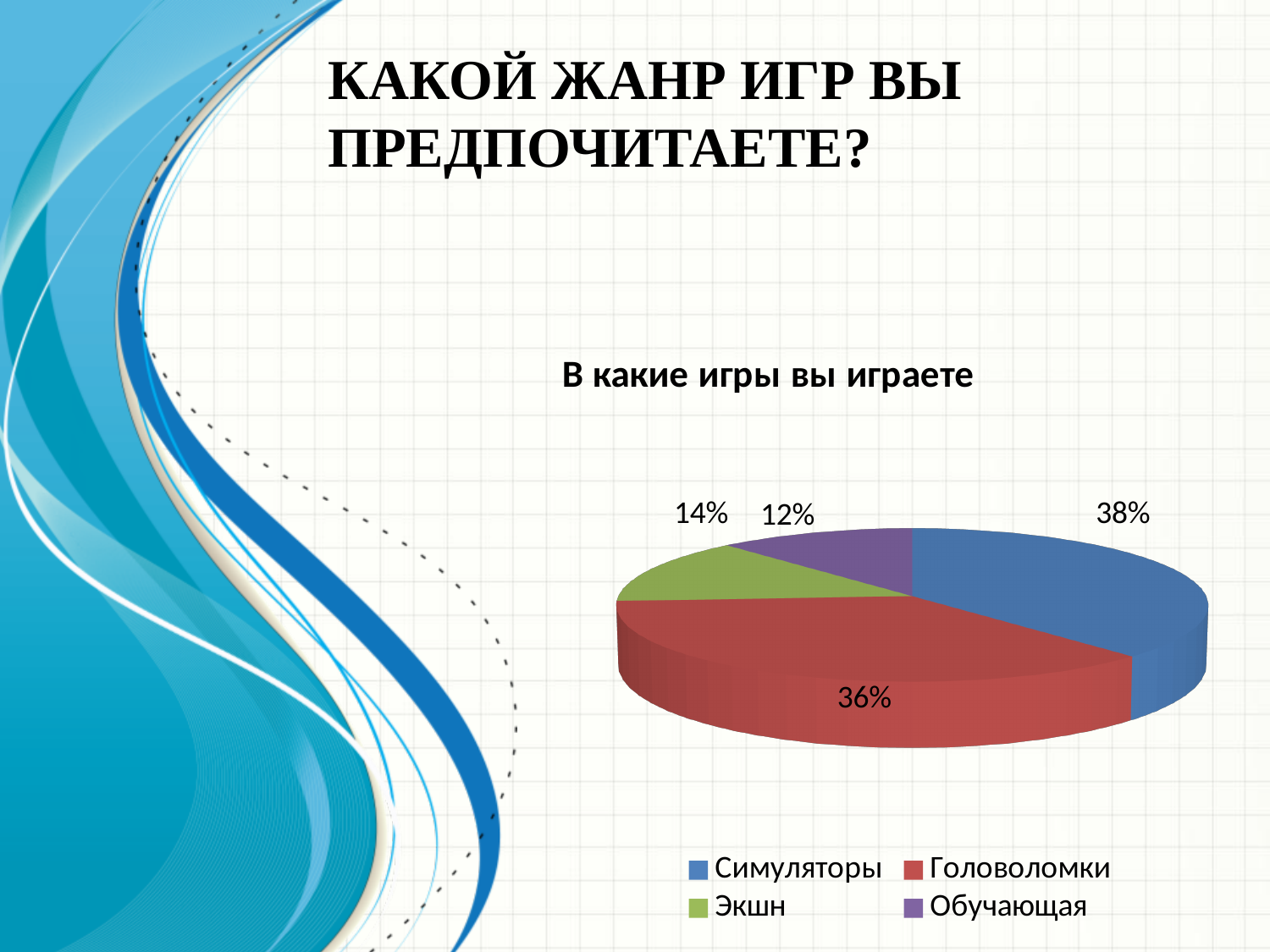
What share of the pie does Экшн have? 14% What colour is the slice for Головоломки? Red Which is larger, the share for Экшн or the share for Обучающая? Экшн What share of the pie does Обучающая have? 12% Which category has the largest slice of the pie? Симуляторы What share of the pie does Симуляторы have? 38% Which category has the smallest slice of the pie? Обучающая How many categories does the pie chart have? 4 What is the title of the chart? В какие игры вы играете What is the difference in percentage points between Симуляторы and Головоломки? 2% What kind of chart is shown on the slide? Pie chart